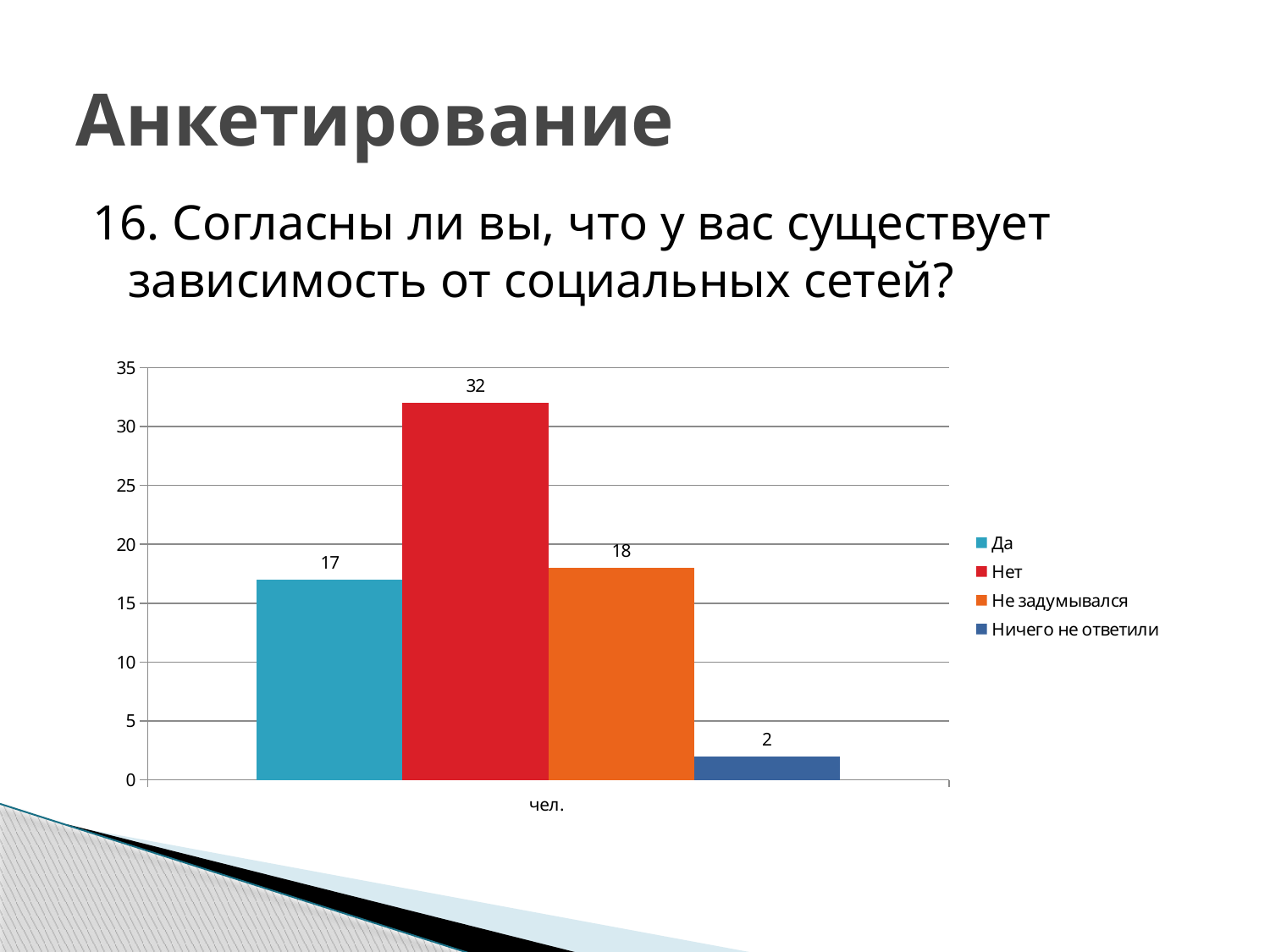
What is the value for "Нет"? 32 What is the value for "Ничего не ответили"? 2 What is the label shown on the x axis of the chart? чел. What is the value for "Да"? 17 What is the value for "Не задумывался"? 18 Which series has the lowest value? Ничего не ответили Is the value for "Нет" greater or less than 30? greater What kind of chart is shown on the slide? bar chart What is the difference between the values for "Нет" and "Да"? 15 Which is larger, the value for "Да" or the value for "Нет"? Нет How many series does the legend list? 4 Which series has the highest value? Нет